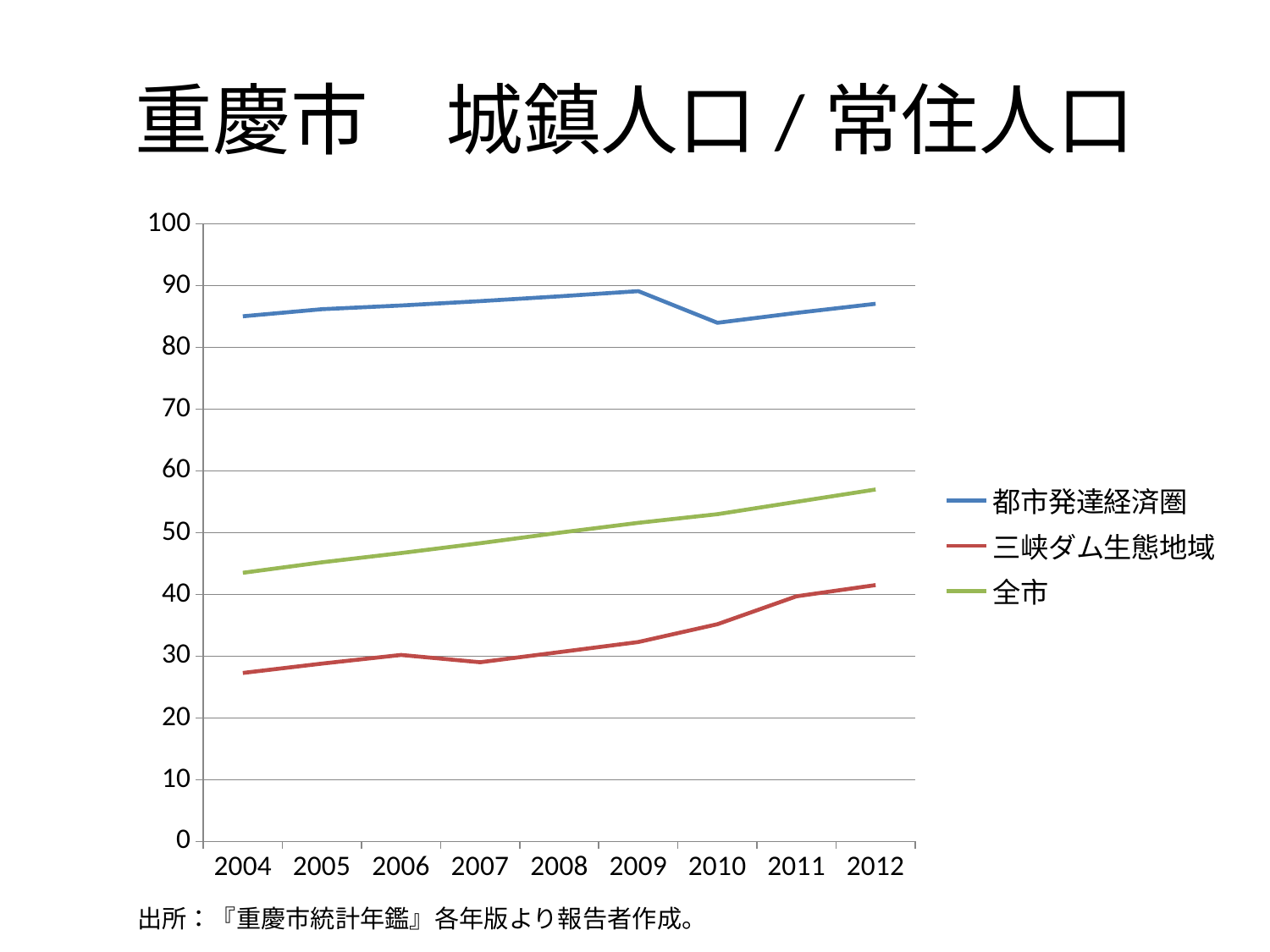
What is the title of the chart on the slide? 重慶市 城鎮人口 / 常住人口 In which year does the 都市発達経済圏 series reach its highest value? 2009 Is the value for 全市 in 2004 greater or less than 50? less In 2012, which is larger: 全市 or 三峡ダム生態地域? 全市 Does the 全市 series rise or fall from 2004 to 2012? rise How many years are plotted along the x axis? 9 Which series has the lowest values across all years? 三峡ダム生態地域 Is the value for 三峡ダム生態地域 in 2004 greater or less than 30? less Is the value for 全市 in 2012 greater or less than 50? greater What kind of chart is shown on the slide? line chart How many series does the legend list? 3